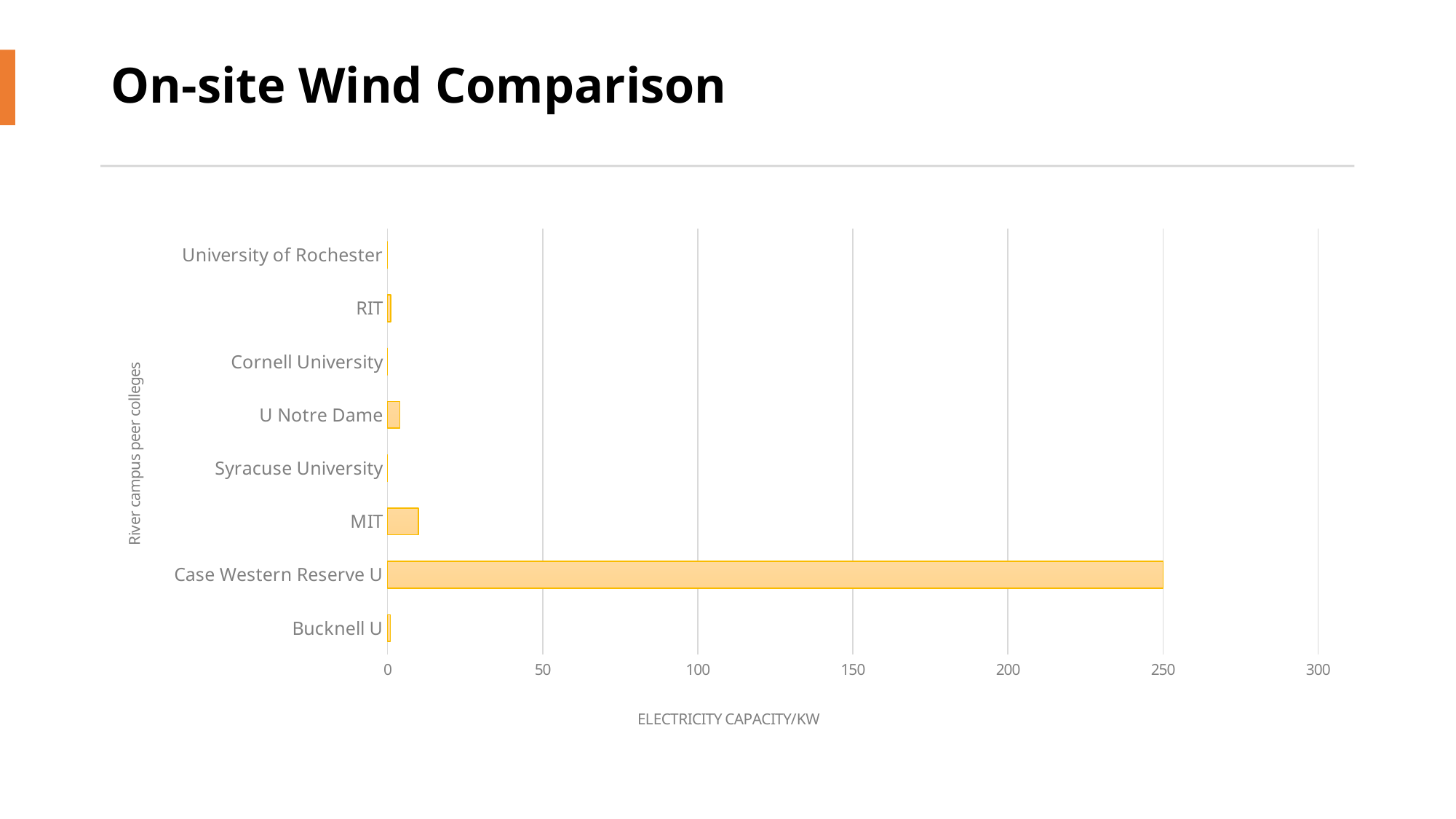
Which has a larger electricity capacity, Case Western Reserve U or MIT? Case Western Reserve U How many colleges are listed on the chart? 8 What kind of chart is shown on the slide? bar chart Is the value for Case Western Reserve U greater or less than 200? greater After Case Western Reserve U, which college has the next highest electricity capacity? MIT What is the label on the vertical axis of the chart? River campus peer colleges Is the value for MIT greater or less than 50? less What is the electricity capacity in kW for Case Western Reserve U? 250 Which college has the highest electricity capacity? Case Western Reserve U Which has a larger electricity capacity, MIT or U Notre Dame? MIT Is the value for U Notre Dame greater or less than 50? less What is the label on the horizontal axis of the chart? ELECTRICITY CAPACITY/KW